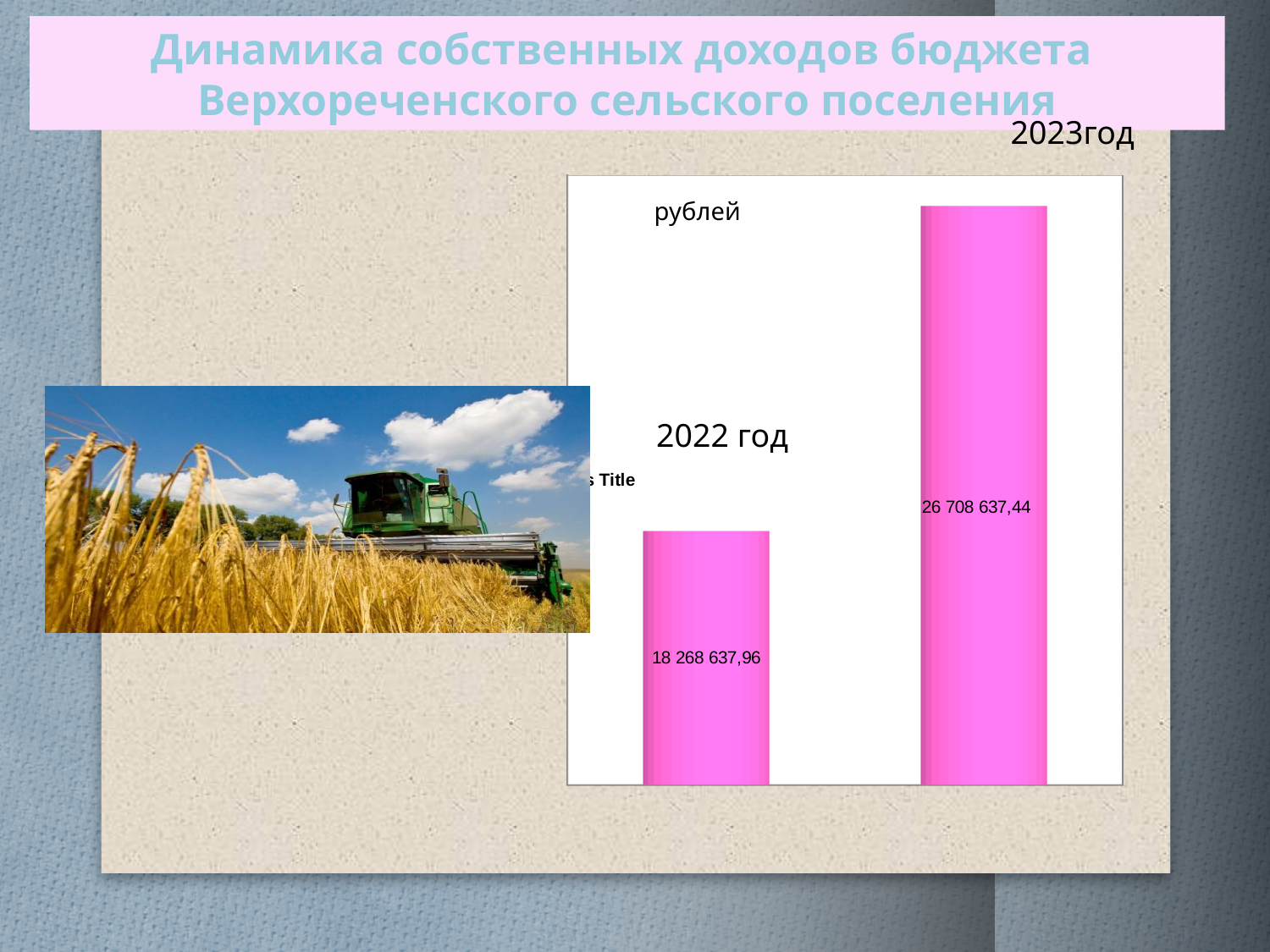
By how much does the 2023 value exceed the 2022 value? 8 439 999,48 What is the combined total of the 2022 and 2023 values? 44 977 275,40 Is the value for 2023 год larger or smaller than the value for 2022 год? larger What unit is indicated for the values on the chart? рублей Which year has the higher value, 2022 or 2023? 2023 How many bars are plotted on the chart? 2 Do the values rise or fall from 2022 to 2023? rise What is the value shown for 2022 год? 18 268 637,96 What is the value shown for 2023 год? 26 708 637,44 What type of chart is shown on the slide? bar chart What colour are the bars on the chart? pink Which year has the lower value on the chart? 2022